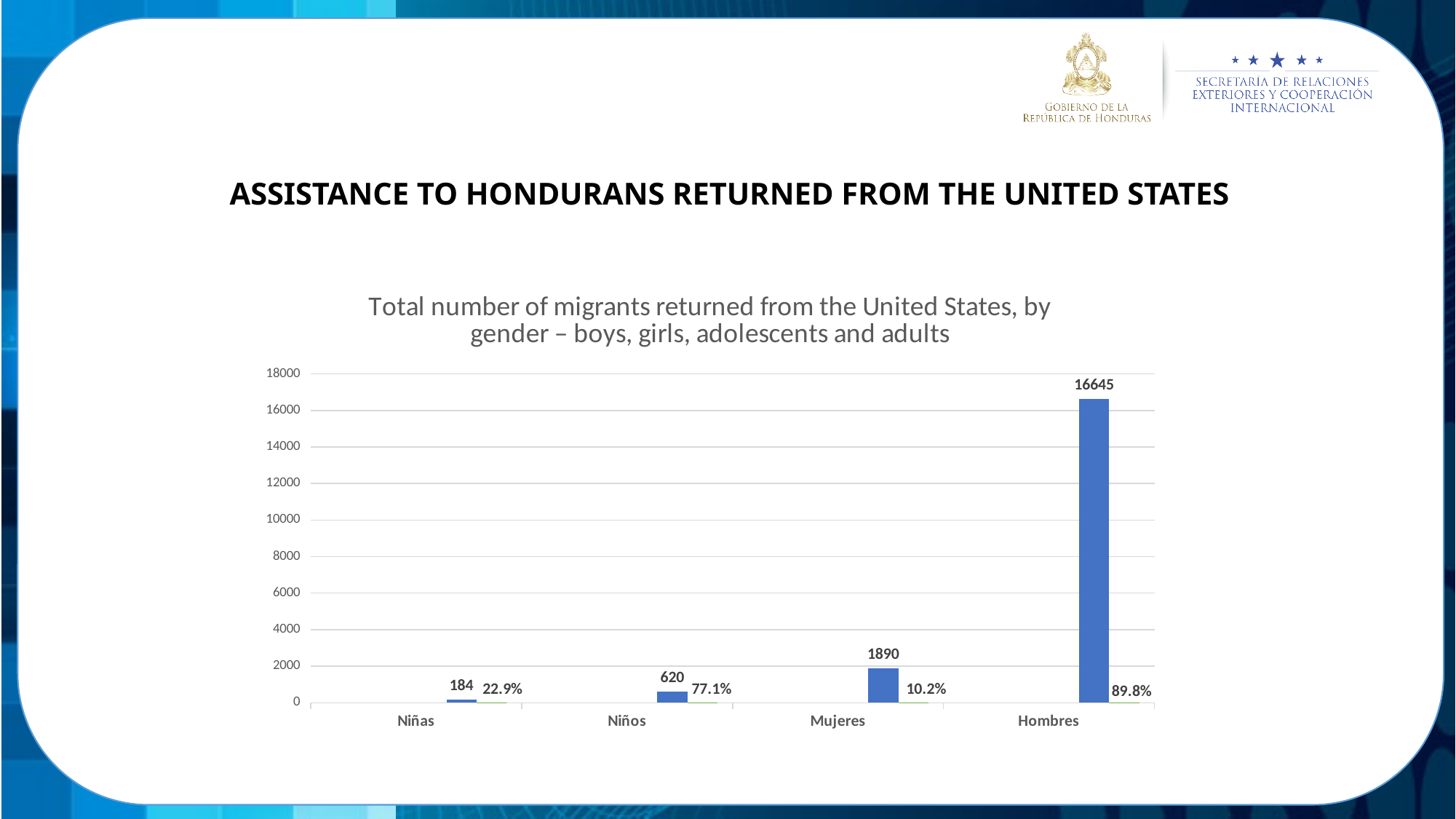
What is the value for Niños? 620 What is the difference between the values for Niños and Niñas? 436 What is the difference between the values for Hombres and Mujeres? 14755 Is the value for Hombres greater or less than 16000? greater What kind of chart is shown on the slide? Bar chart What is the value for Mujeres? 1890 Which category has the lowest value? Niñas What is the value for Hombres? 16645 Which category has the highest value? Hombres What is the value for Niñas? 184 How many categories are shown on the x axis? 4 Which is larger, the value for Mujeres or the value for Niños? Mujeres